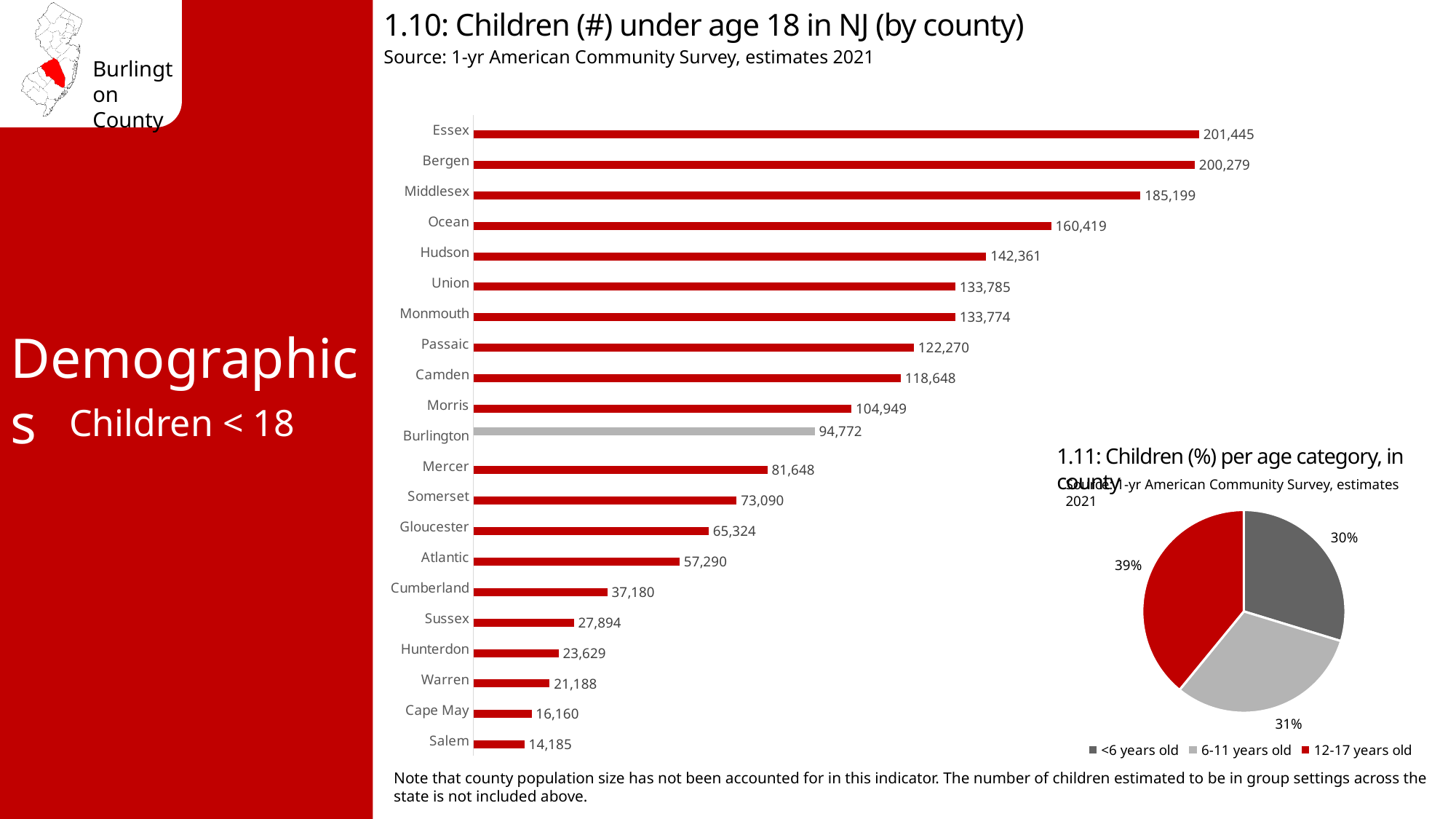
In the bar chart '1.10: Children (#) under age 18 in NJ (by county)', what is the difference between the values for Essex and Bergen? 1,166 In the bar chart '1.10: Children (#) under age 18 in NJ (by county)', how many counties are shown? 21 In the bar chart '1.10: Children (#) under age 18 in NJ (by county)', which county has the lowest value? Salem In the bar chart '1.10: Children (#) under age 18 in NJ (by county)', what is the value for Cape May? 16,160 In the bar chart '1.10: Children (#) under age 18 in NJ (by county)', what is the value for Burlington? 94,772 In the bar chart '1.10: Children (#) under age 18 in NJ (by county)', which county has the highest value? Essex In the bar chart '1.10: Children (#) under age 18 in NJ (by county)', which has a larger value, Ocean or Hudson? Ocean In the pie chart '1.11: Children (%) per age category, in county', which age category has the smallest share? <6 years old In the bar chart '1.10: Children (#) under age 18 in NJ (by county)', which bar is coloured grey instead of red? Burlington In the pie chart '1.11: Children (%) per age category, in county', what share is 12-17 years old? 39% In the pie chart '1.11: Children (%) per age category, in county', how many categories does the legend list? 3 What kind of chart is '1.10: Children (#) under age 18 in NJ (by county)'? Bar chart